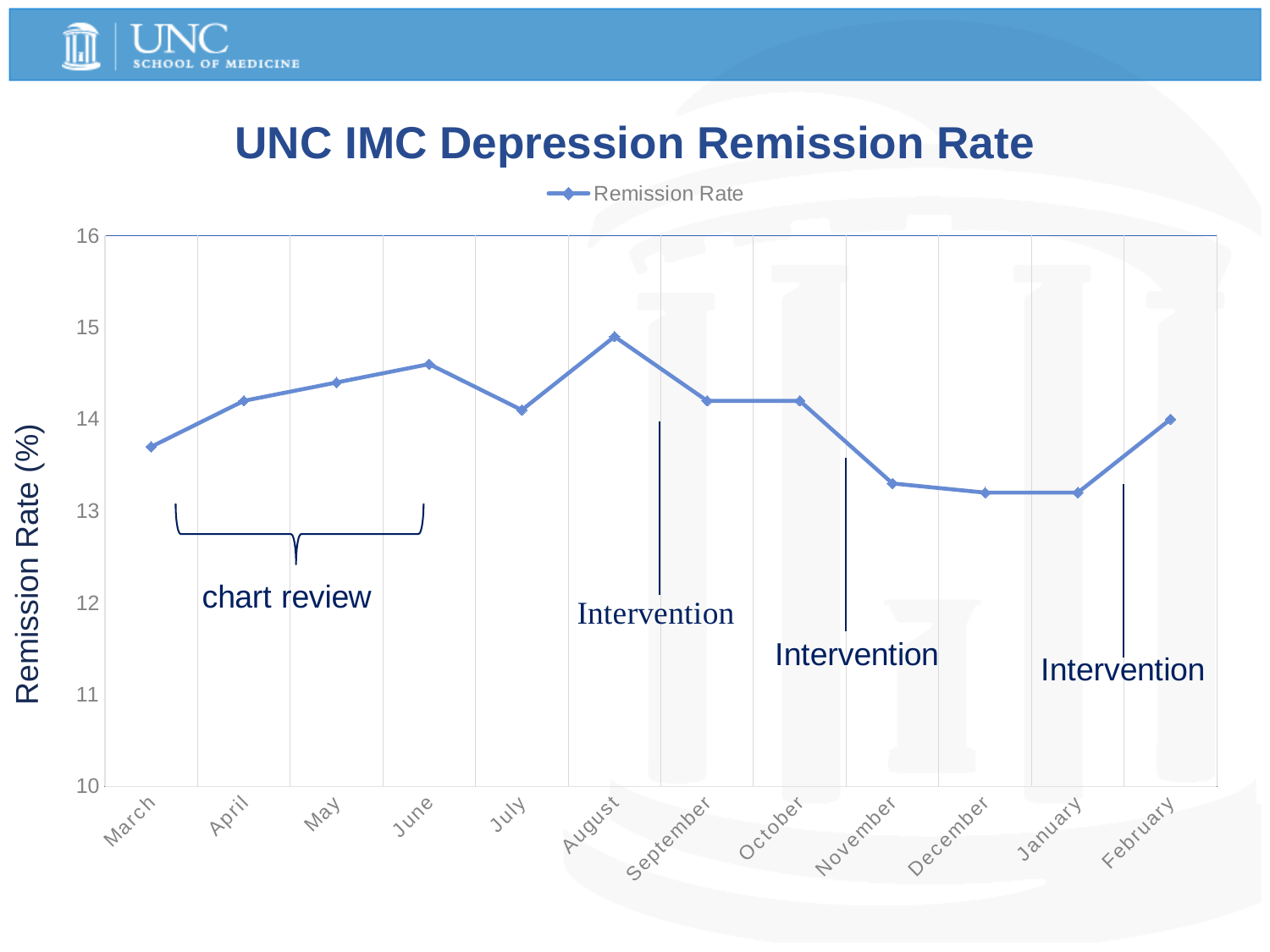
Does the remission rate rise or fall from March to June? rise Is the remission rate for June greater or less than 15? less Which month has the highest remission rate? August What kind of chart is shown on the slide? line chart Which month has the higher remission rate, August or December? August How many series does the legend list? 1 How many months are plotted along the x axis? 12 Is the remission rate for March greater or less than 13? greater What is the label on the y axis? Remission Rate (%) What is the title of the chart? UNC IMC Depression Remission Rate Is the remission rate for November greater or less than 14? less